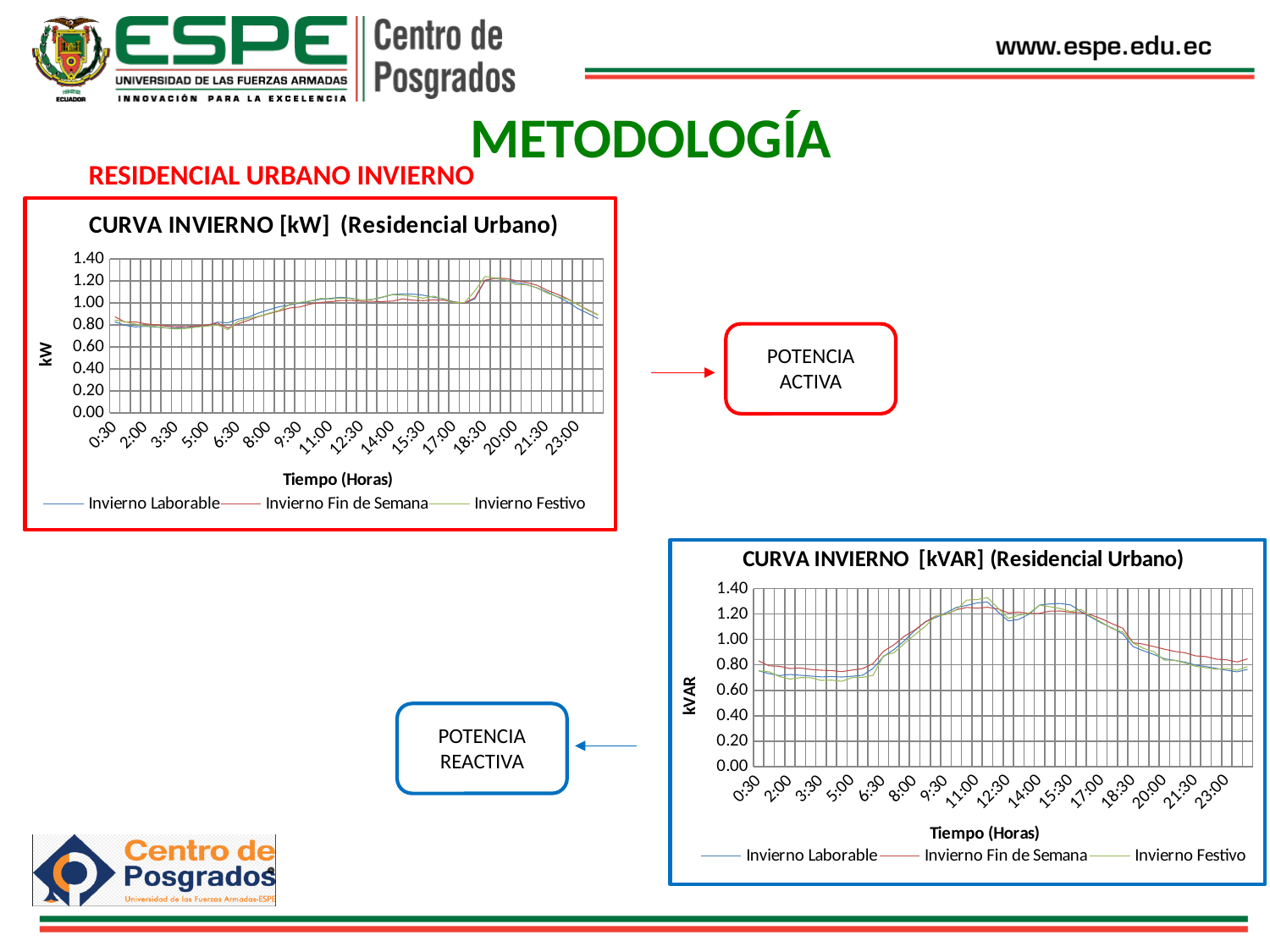
How many series does the legend of the 'CURVA INVIERNO [kVAR] (Residencial Urbano)' chart list? 3 What is the x-axis title of the 'CURVA INVIERNO [kVAR] (Residencial Urbano)' chart? Tiempo (Horas) In the 'CURVA INVIERNO [kVAR] (Residencial Urbano)' chart, do the values rise or fall between 6:30 and 11:00? rise What kind of chart is the 'CURVA INVIERNO [kW] (Residencial Urbano)' chart? line chart In the 'CURVA INVIERNO [kVAR] (Residencial Urbano)' chart, is the value for Invierno Laborable at 3:30 greater or less than 0.80? less What kind of chart is the 'CURVA INVIERNO [kVAR] (Residencial Urbano)' chart? line chart In the 'CURVA INVIERNO [kW] (Residencial Urbano)' chart, do the values rise or fall between 20:00 and 23:00? fall In the 'CURVA INVIERNO [kW] (Residencial Urbano)' chart, is the value for Invierno Laborable at 0:30 greater or less than 1.00? less In the 'CURVA INVIERNO [kVAR] (Residencial Urbano)' chart, is the value for Invierno Laborable at 11:00 greater or less than 1.00? greater How many series does the legend of the 'CURVA INVIERNO [kW] (Residencial Urbano)' chart list? 3 What is the y-axis label of the 'CURVA INVIERNO [kW] (Residencial Urbano)' chart? kW